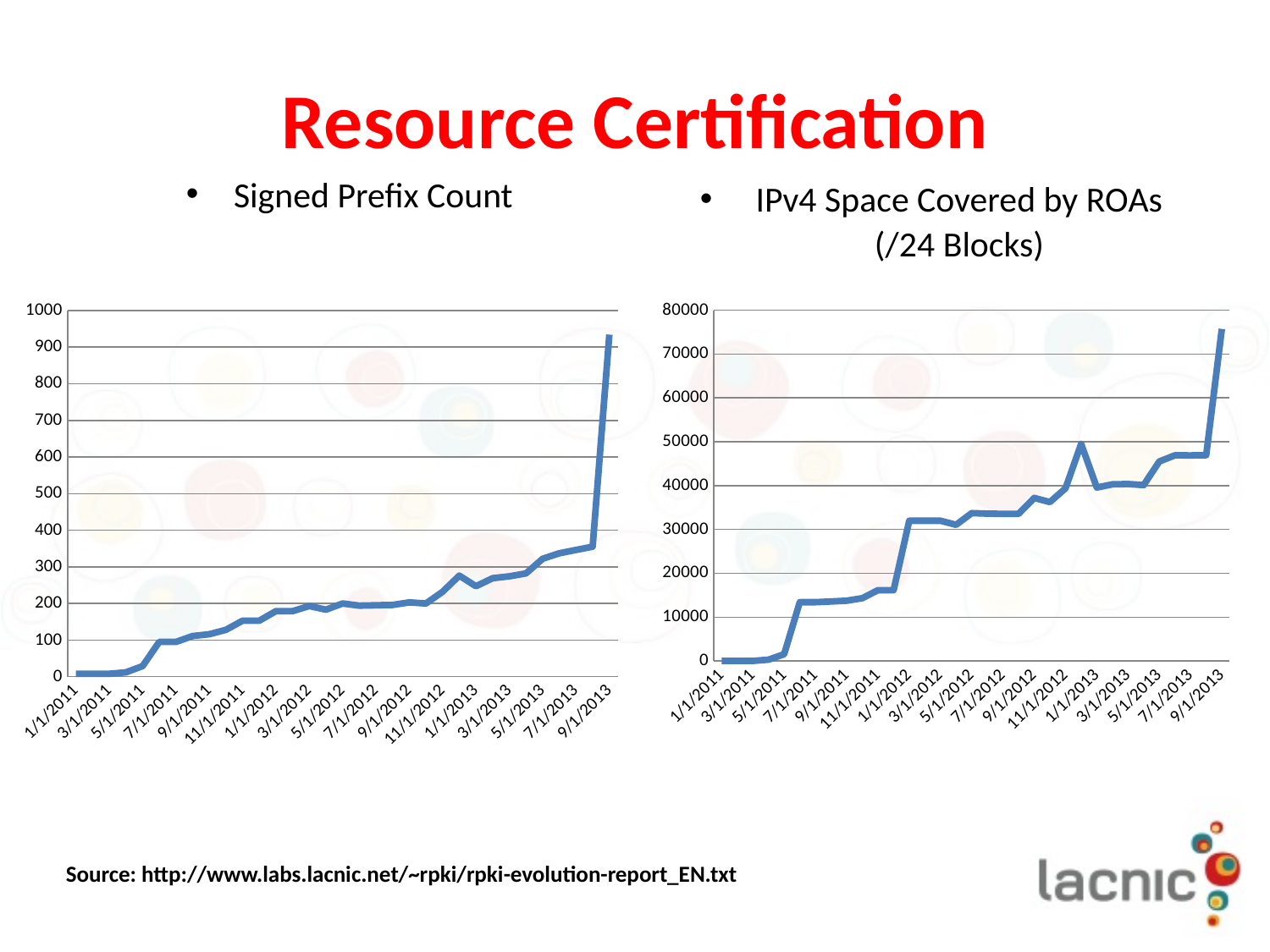
In the IPv4 Space Covered by ROAs chart, is the value at 5/1/2011 greater or less than 10000? less In the Signed Prefix Count chart, at which date is the value highest? 9/1/2013 In the Signed Prefix Count chart, do the values generally rise or fall from 1/1/2011 to 9/1/2013? rise In the Signed Prefix Count chart, is the value at 1/1/2012 greater or less than 200? less What type of chart is the IPv4 Space Covered by ROAs chart on the right? line chart In the Signed Prefix Count chart, is the value at 9/1/2013 greater or less than 900? greater What type of chart is the Signed Prefix Count chart on the left? line chart In the IPv4 Space Covered by ROAs chart, do the values generally rise or fall over the period shown? rise In the IPv4 Space Covered by ROAs chart, at which date is the value highest? 9/1/2013